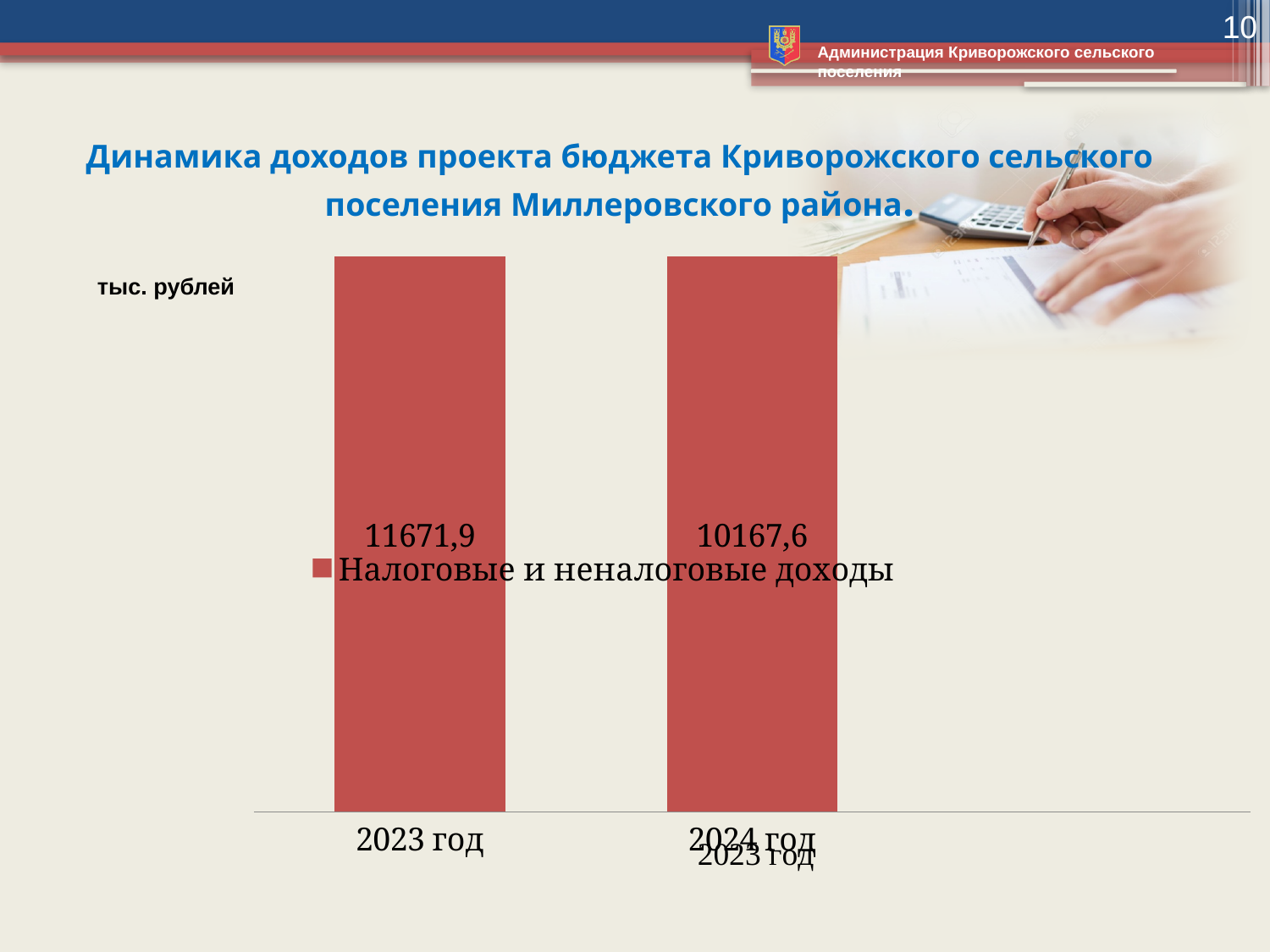
Which year has the higher value of налоговые и неналоговые доходы? 2023 год Is the value for 2023 год larger or smaller than the value for 2024 год? larger What kind of chart is shown on the slide? bar chart What is the difference between the values for 2023 год and 2024 год? 1504,3 What series name is shown in the chart legend? Налоговые и неналоговые доходы Do the values rise or fall from 2023 год to 2024 год? fall In what units are the chart values given? тыс. рублей What is the value for 2023 год? 11671,9 What is the value for 2024 год? 10167,6 Which year has the lower value of налоговые и неналоговые доходы? 2024 год How many bars are plotted in the chart? 2 How many series does the legend list? 1